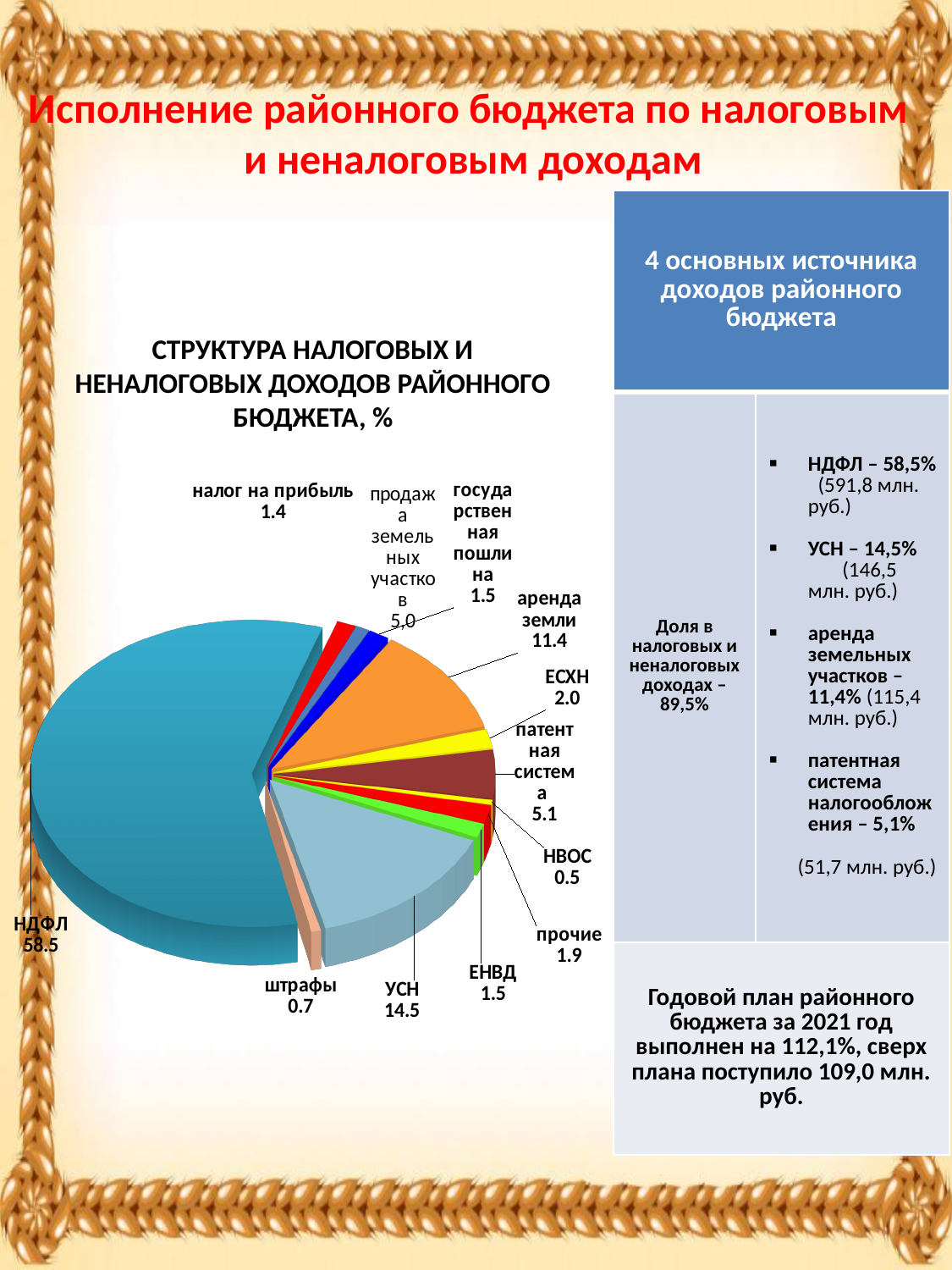
What is the value for НДФЛ in the pie chart? 58.5 Which is larger, the value for аренда земли or the value for продажа земельных участков? аренда земли What is the title of the chart? СТРУКТУРА НАЛОГОВЫХ И НЕНАЛОГОВЫХ ДОХОДОВ РАЙОННОГО БЮДЖЕТА, % Which category has the largest slice of the pie chart? НДФЛ What is the value for аренда земли in the pie chart? 11.4 What is the value for штрафы in the pie chart? 0.7 What kind of chart is shown on the slide? pie chart How many categories are shown in the pie chart? 12 What is the value for УСН in the pie chart? 14.5 Which category has the smallest slice of the pie chart? НВОС What is the difference between the values for НДФЛ and УСН? 44.0 What is the value for патентная система in the pie chart? 5.1